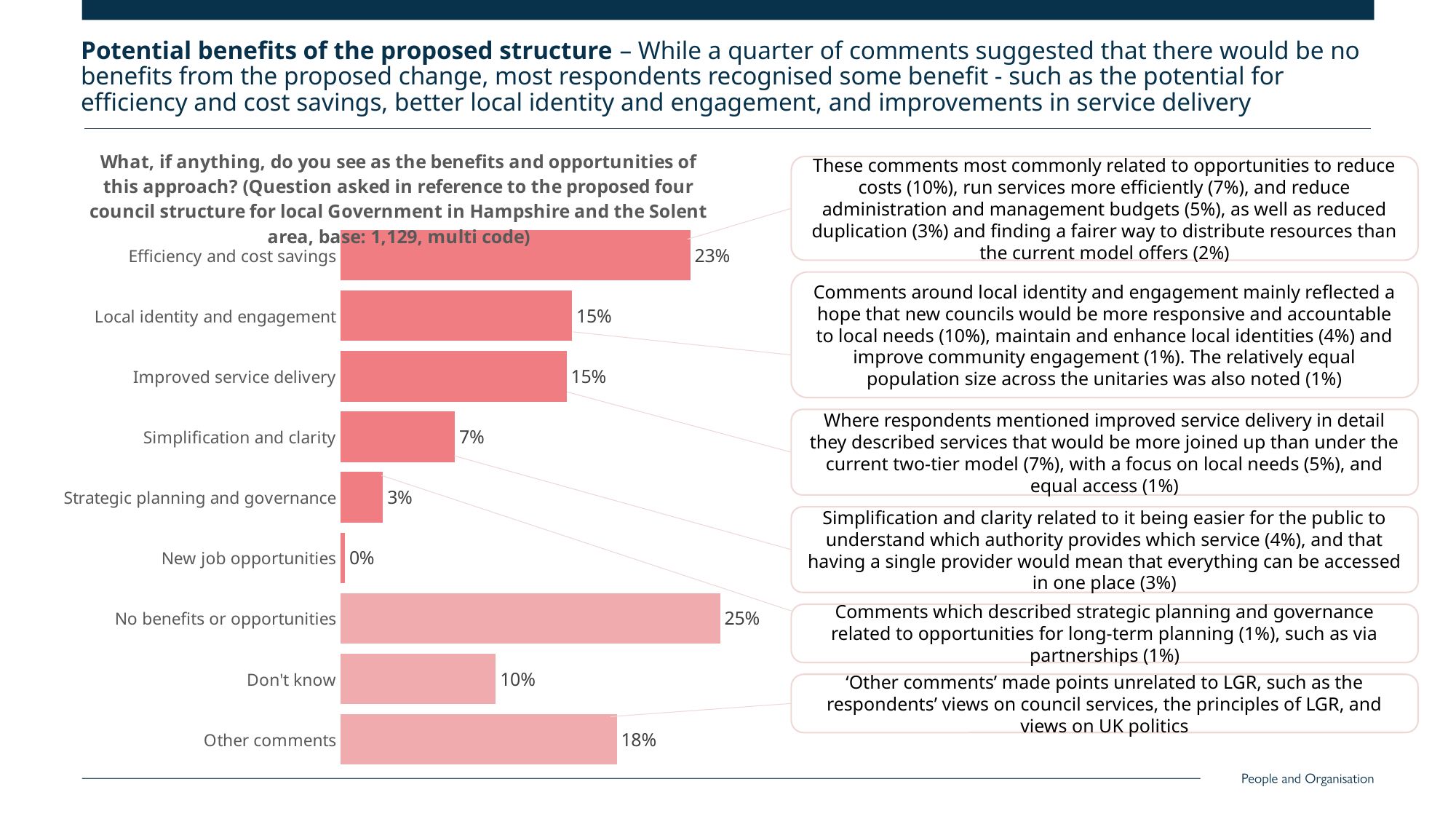
What is the value for 'Strategic planning and governance'? 3% What is the difference between the values for 'No benefits or opportunities' and 'Efficiency and cost savings'? 2 percentage points What percentage of comments mentioned efficiency and cost savings as a benefit? 23% What percentage is shown for 'Don't know'? 10% What is the difference between the values for 'Simplification and clarity' and 'Strategic planning and governance'? 4 percentage points What is the value shown for 'No benefits or opportunities'? 25% What type of chart is shown on the slide? Bar chart Which is larger: the value for 'Other comments' or the value for 'Local identity and engagement'? Other comments What is the base (number of respondents) stated in the chart title? 1,129 How many categories are shown in the bar chart? 9 Which category has the lowest value in the chart? New job opportunities Which category has the highest value in the chart? No benefits or opportunities